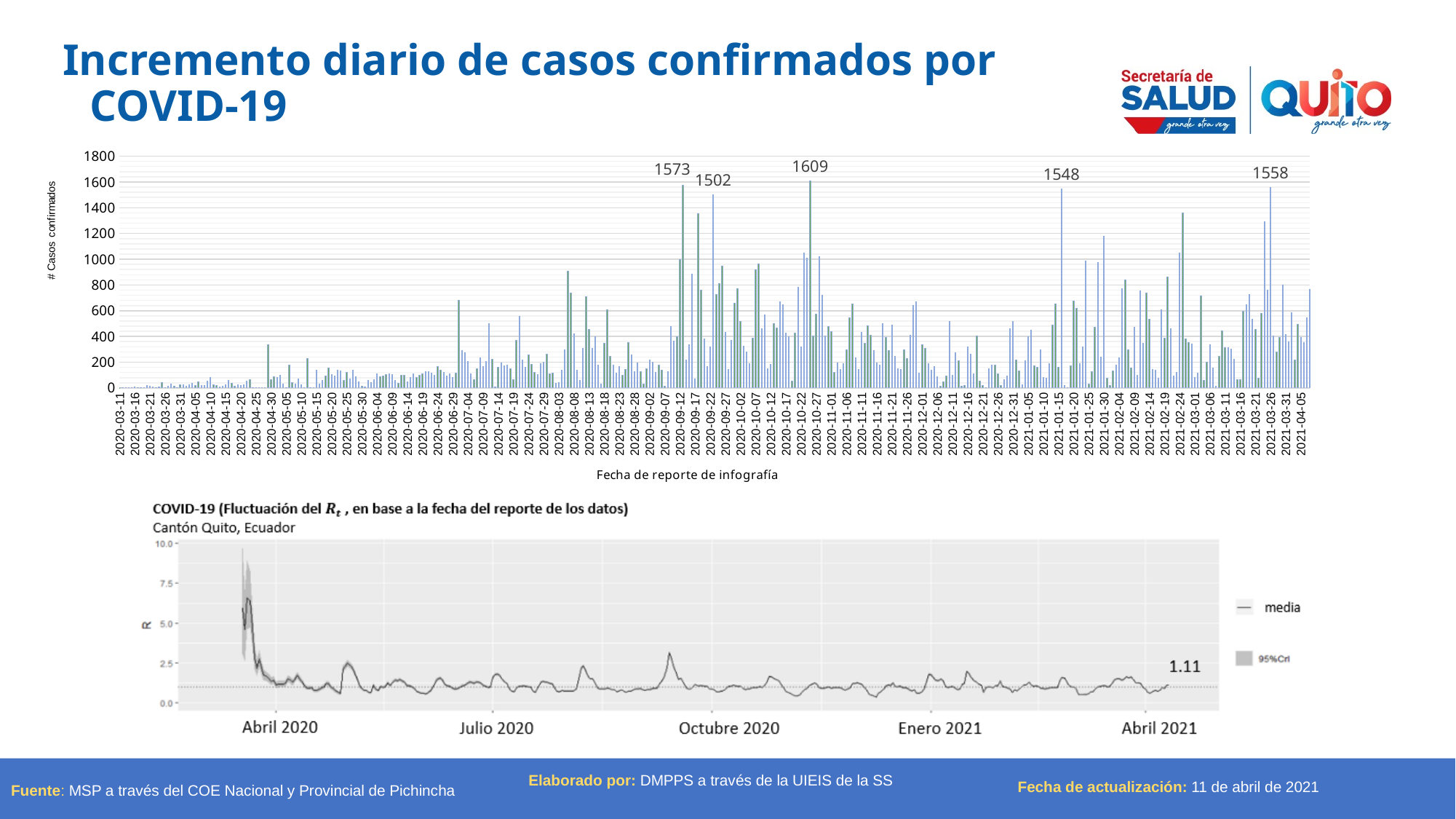
What kind of chart is the top chart showing daily confirmed COVID-19 cases? Bar chart In the top bar chart of daily confirmed cases, what is the highest labelled value? 1609 In the top bar chart, which labelled peak is larger, 1548 or 1558? 1558 What is the x-axis title of the top chart? Fecha de reporte de infografía In the top bar chart, which labelled peak is larger, 1573 or 1502? 1573 In the top bar chart, what is the difference between the labelled peaks 1558 and 1548? 10 In the top bar chart, what is the difference between the labelled peaks 1609 and 1573? 36 In the bottom Rt chart, what is the value labelled at the end of the line near Abril 2021? 1.11 In the top bar chart, what is the difference between the labelled peaks 1573 and 1502? 71 What is the y-axis label of the top chart? # Casos confirmados How many entries does the legend of the bottom Rt chart list? 2 What kind of chart is the bottom chart showing the fluctuation of Rt for Cantón Quito? Line chart